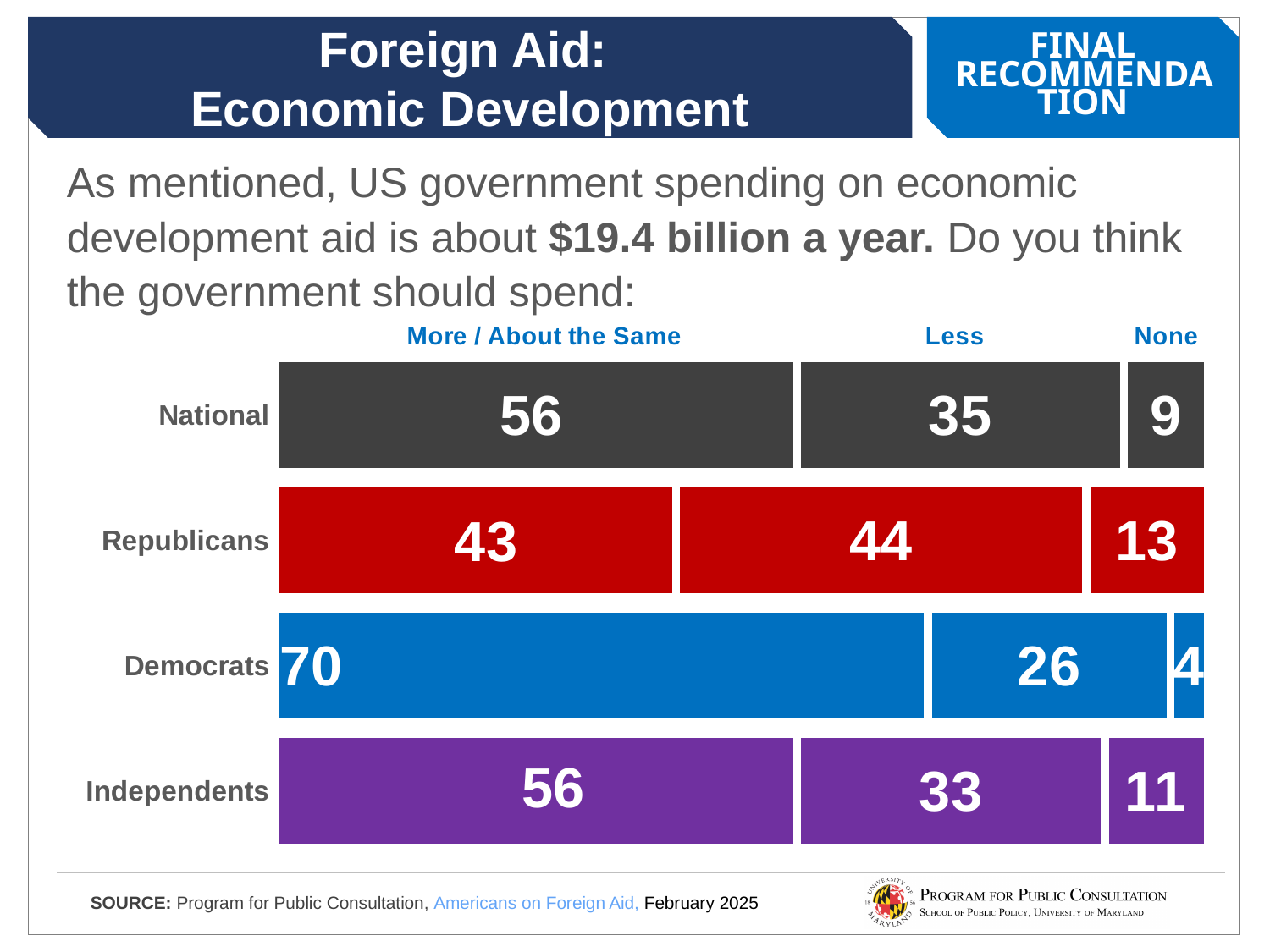
Which is larger: the 'None' value for Republicans or for National? Republicans What is the 'Less' value for Republicans? 44 Which group has the highest 'More / About the Same' value? Democrats Which group has the lowest 'None' value? Democrats What is the difference between the 'Less' values for Republicans and Democrats? 18 What kind of chart is shown on the slide? Stacked bar chart What colour is the Independents bar? Purple How many response categories are shown across the top of the chart? 3 How many groups (bars) are shown in the chart? 4 What is the 'None' value for Independents? 11 What is the 'More / About the Same' value for Democrats? 70 What is the total of the three segments in the Republicans bar? 100